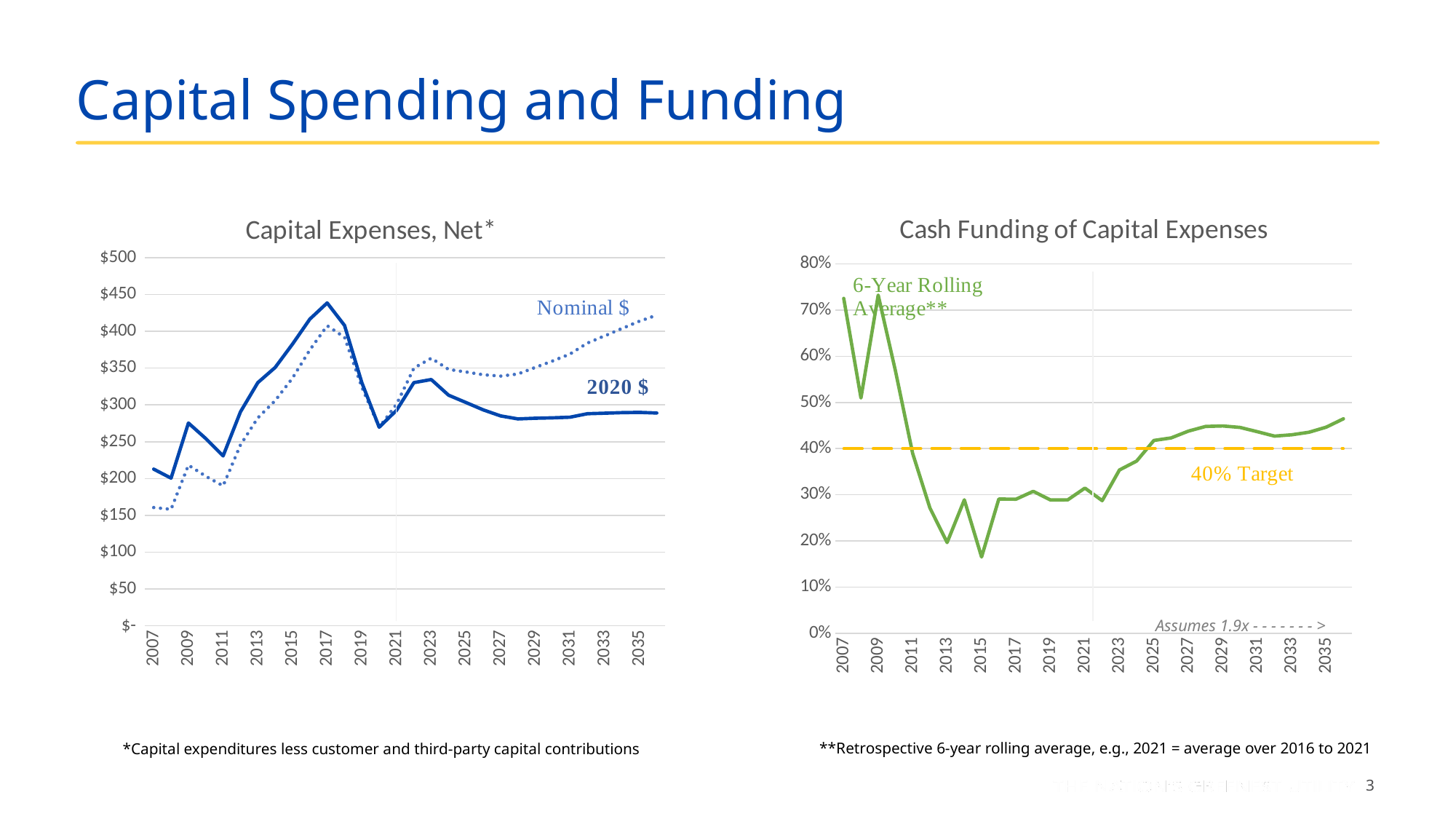
In the 'Cash Funding of Capital Expenses' chart, what percentage is the dashed target line set at? 40% In the 'Capital Expenses, Net*' chart, which series is higher in 2035, Nominal $ or 2020 $? Nominal $ In the 'Cash Funding of Capital Expenses' chart, in which year is the 6-Year Rolling Average at its lowest? 2015 In the 'Capital Expenses, Net*' chart, how many data series are plotted? 2 What is the title of the chart on the right side of the slide? Cash Funding of Capital Expenses In the 'Capital Expenses, Net*' chart, is the Nominal $ value for 2007 greater or less than $200? less What kind of chart is the 'Capital Expenses, Net*' chart on the left? line chart In the 'Cash Funding of Capital Expenses' chart, is the 6-Year Rolling Average for 2015 greater or less than 20%? less In the 'Capital Expenses, Net*' chart, which series is higher in 2009, Nominal $ or 2020 $? 2020 $ In the 'Capital Expenses, Net*' chart, is the 2020 $ value for 2017 greater or less than $400? greater In the 'Capital Expenses, Net*' chart, in which year does the 2020 $ series reach its highest value? 2017 In the 'Capital Expenses, Net*' chart, does the Nominal $ series rise or fall from 2027 to 2035? rise